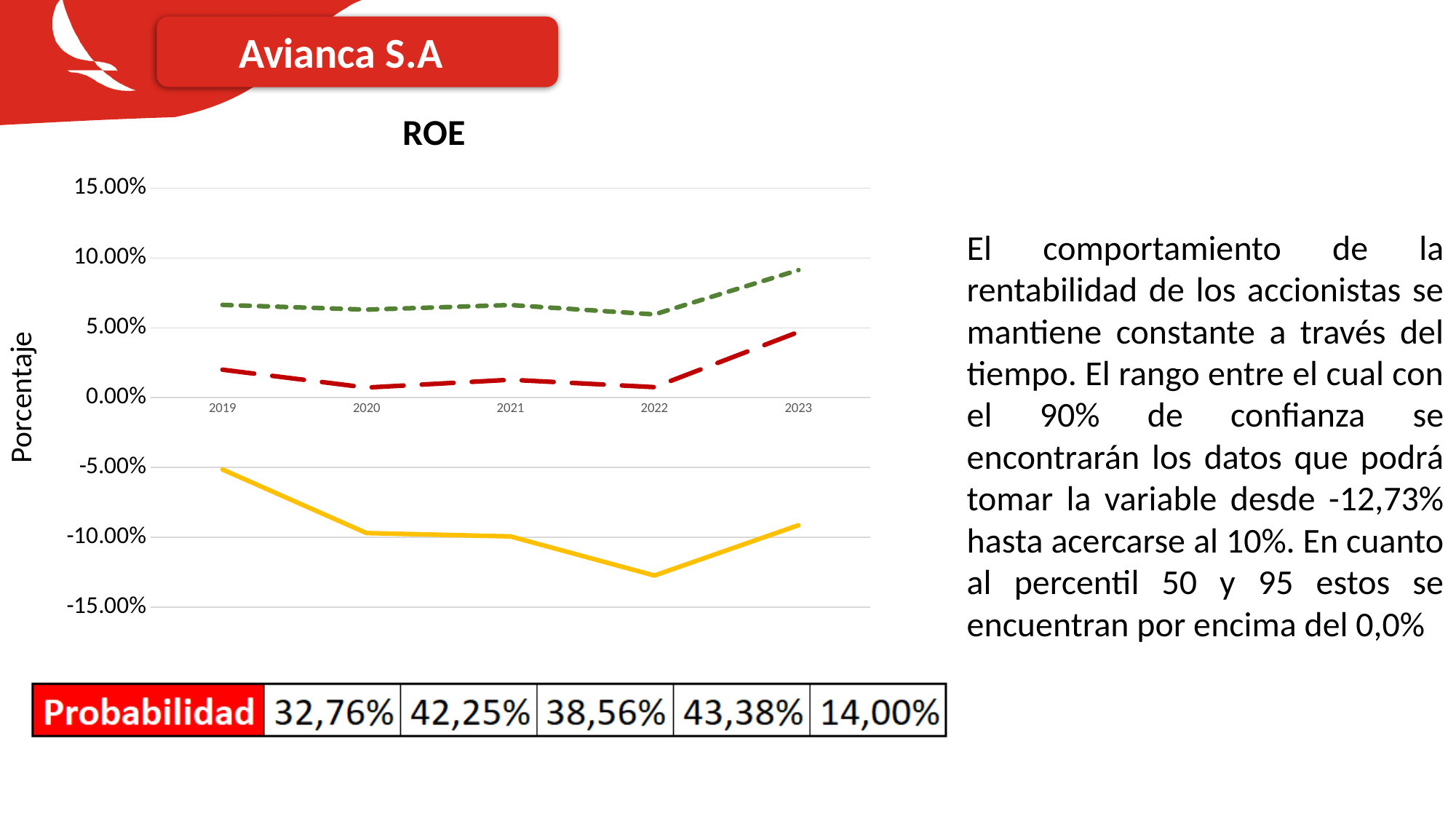
What kind of chart is shown on the slide? line chart Is the value of the green dotted line in 2023 greater or less than 5.00%? greater What is the label on the vertical axis of the chart? Porcentaje Is the value of the yellow solid line in 2022 greater or less than -10.00%? less Is the value of the red dashed line in 2023 greater or less than 0.00%? greater Does the yellow solid line rise or fall from 2019 to 2022? fall In which year does the yellow solid line reach its lowest value? 2022 What is the title of the chart? ROE How many years are plotted along the x axis of the chart? 5 In which year does the green dotted line reach its highest value? 2023 How many lines are plotted in the chart? 3